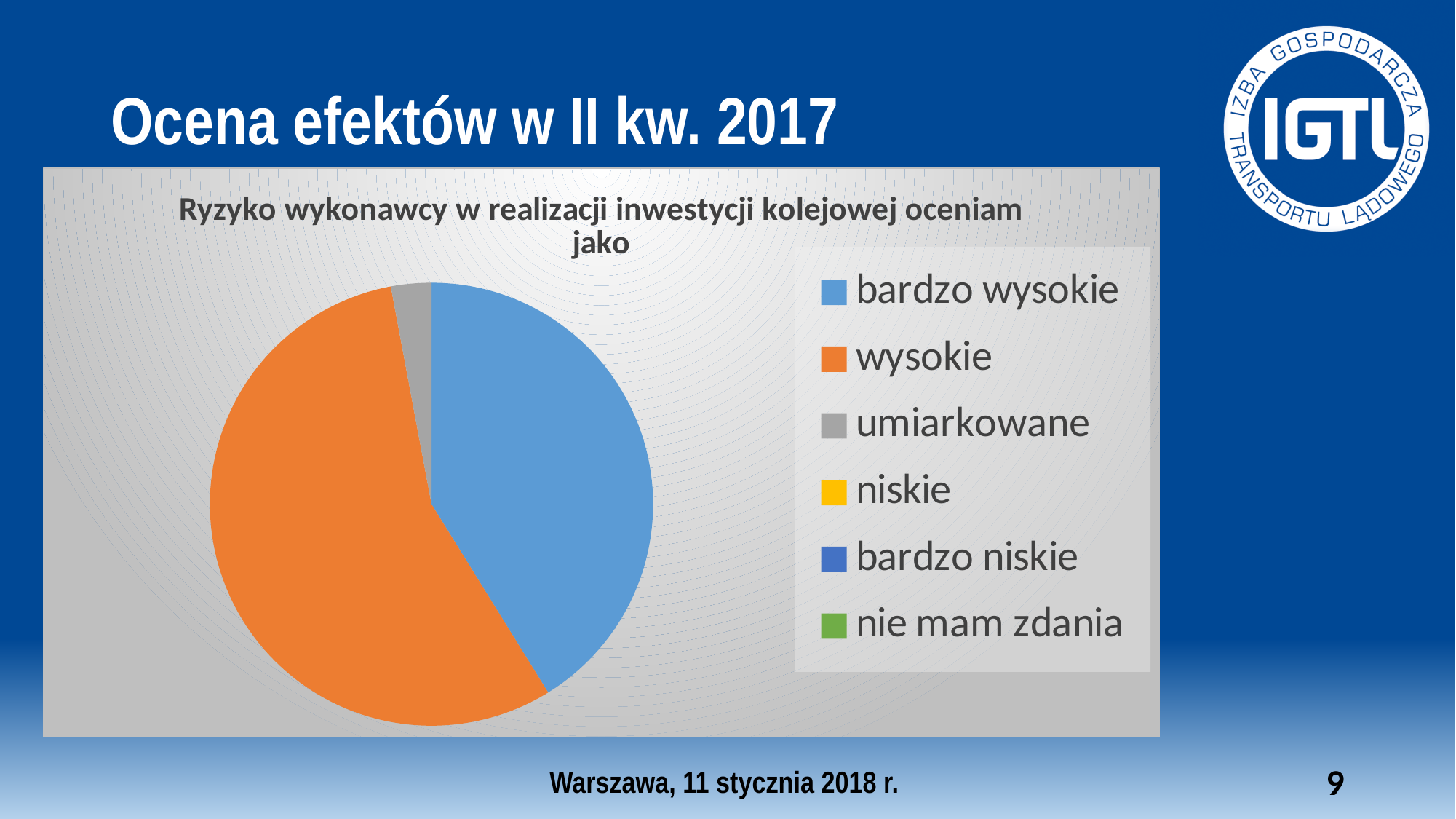
What is the title of the chart? Ryzyko wykonawcy w realizacji inwestycji kolejowej oceniam jako How many categories are listed in the chart's legend? 6 What colour is the "wysokie" slice? orange How many data series does the pie chart plot? 1 Which of the three visible slices is the smallest? umiarkowane Which category has the largest slice of the pie? wysokie What kind of chart is shown on the slide? pie chart Which slice is larger, "wysokie" or "bardzo wysokie"? wysokie Which slice is larger, "bardzo wysokie" or "umiarkowane"? bardzo wysokie